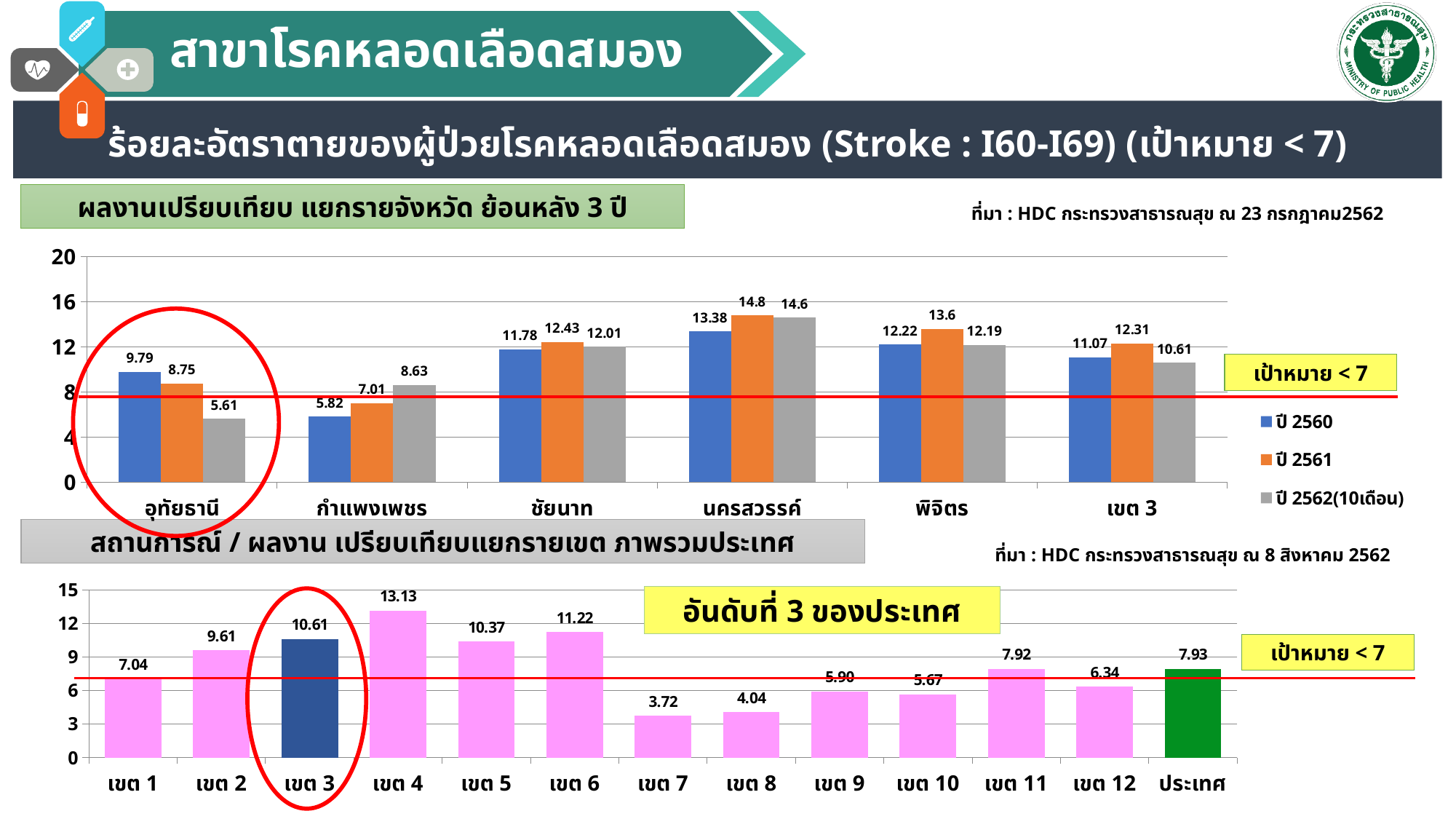
In the bottom chart, which category has the lowest value? เขต 7 In the top chart, what is the difference between the ปี 2561 and ปี 2560 values for พิจิตร? 1.38 In the top chart, how many series does the legend list? 3 In the top chart, which category has the lowest value in the ปี 2561 series? กำแพงเพชร In the bottom chart, how many bars are plotted? 13 In the top chart, which province has the highest value in the ปี 2560 series? นครสวรรค์ What type of chart is the bottom chart? Bar chart In the top chart, is the ปี 2560 value for ชัยนาท greater or less than the ปี 2562(10เดือน) value for ชัยนาท? less In the bottom chart, what is the value for เขต 4? 13.13 In the top chart, what is the value for นครสวรรค์ in the ปี 2561 series? 14.8 In the top chart, what is the value for อุทัยธานี in the ปี 2562(10เดือน) series? 5.61 In the bottom chart, what is the difference between the values for เขต 3 and ประเทศ? 2.68